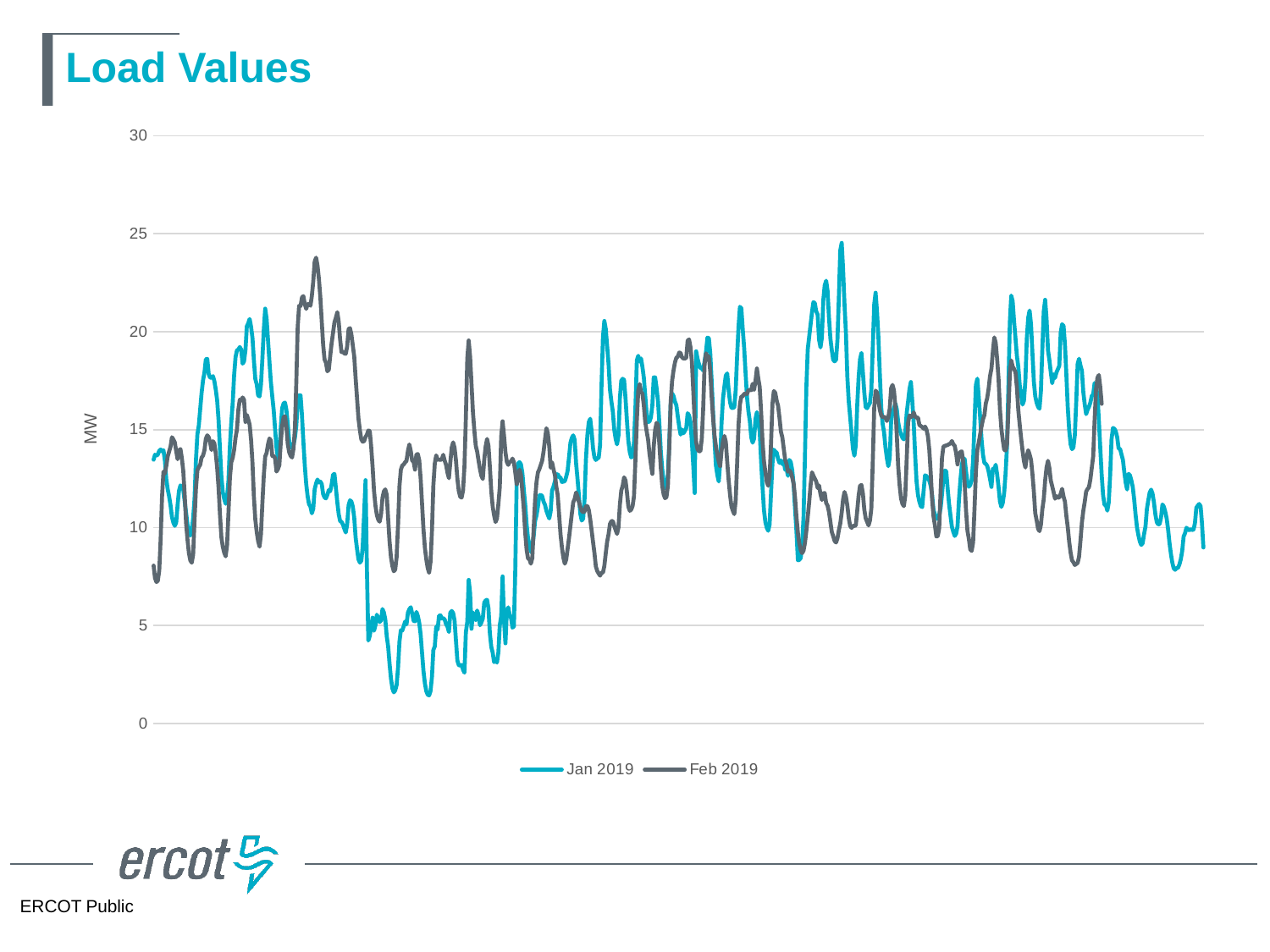
What is the title of the chart? Load Values Is the highest value reached by the Jan 2019 series greater or less than 20? greater What kind of chart is shown on the slide? line chart How many series does the legend list? 2 Is the highest value reached by the Feb 2019 series greater or less than 25? less Which series drops to the lower minimum value, Jan 2019 or Feb 2019? Jan 2019 What is the highest value shown on the vertical axis? 30 What is the label on the vertical axis? MW Is the lowest value reached by the Jan 2019 series greater or less than 5? less